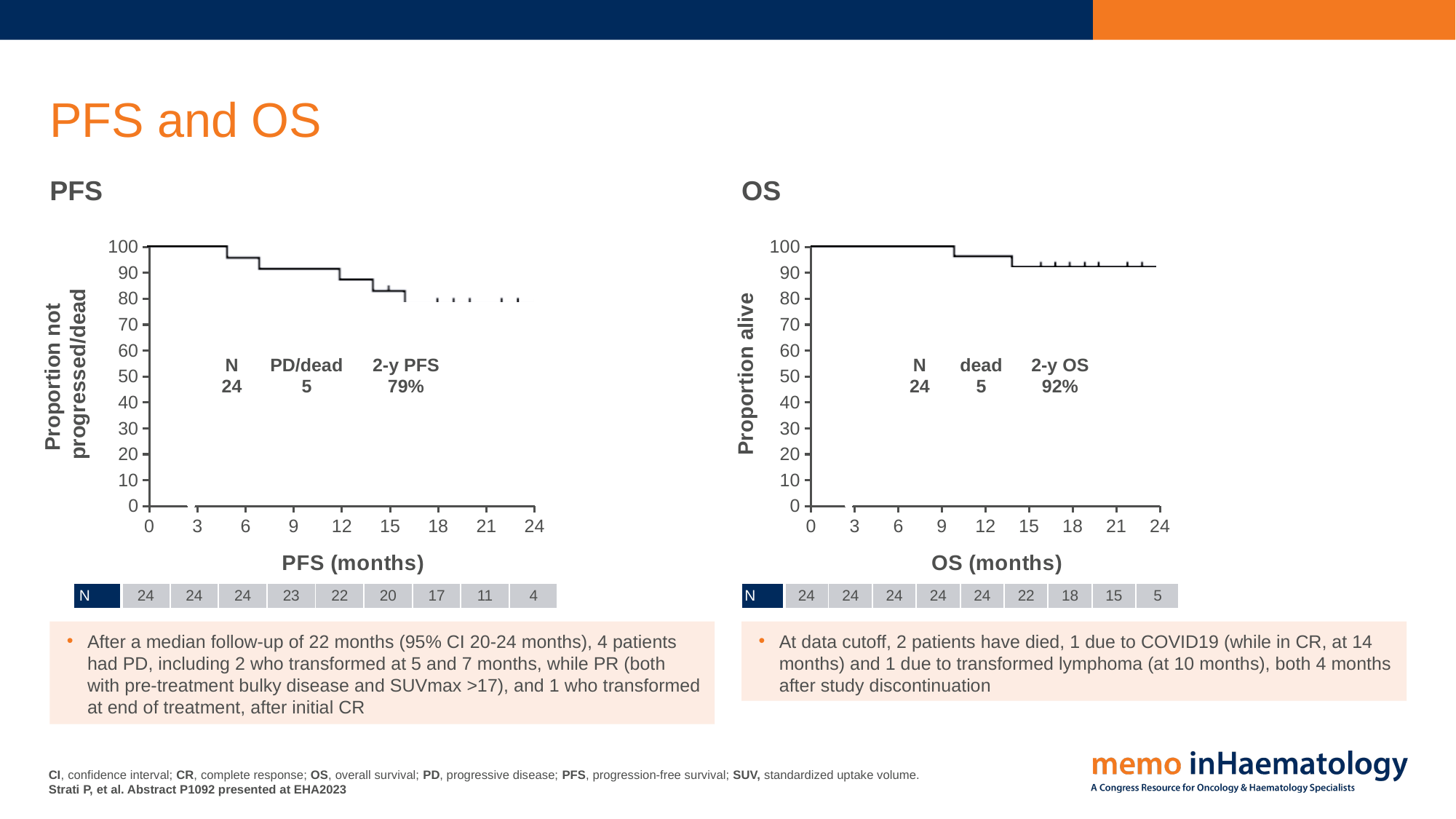
On the OS chart, what is the 2-year OS rate shown? 92% What is the difference between the 2-year OS rate (OS chart) and the 2-year PFS rate (PFS chart)? 13 percentage points On the OS chart, how many patients are at risk at 24 months according to the number-at-risk row? 5 On the PFS chart, what is the 2-year PFS rate shown? 79% On the PFS chart, how many patients had PD/dead according to the inset table? 5 On the PFS chart, is the proportion not progressed/dead at 12 months greater or less than 80? greater On the OS chart, is the proportion alive at 24 months greater or less than 80? greater Which is higher, the 2-year OS rate on the OS chart or the 2-year PFS rate on the PFS chart? 2-year OS On the PFS chart, how many patients are at risk at 24 months according to the number-at-risk row? 4 What is the y-axis label of the OS chart? Proportion alive On the OS chart, what is N in the inset table? 24 On the PFS chart, how many patients are at risk at 18 months according to the number-at-risk row? 17